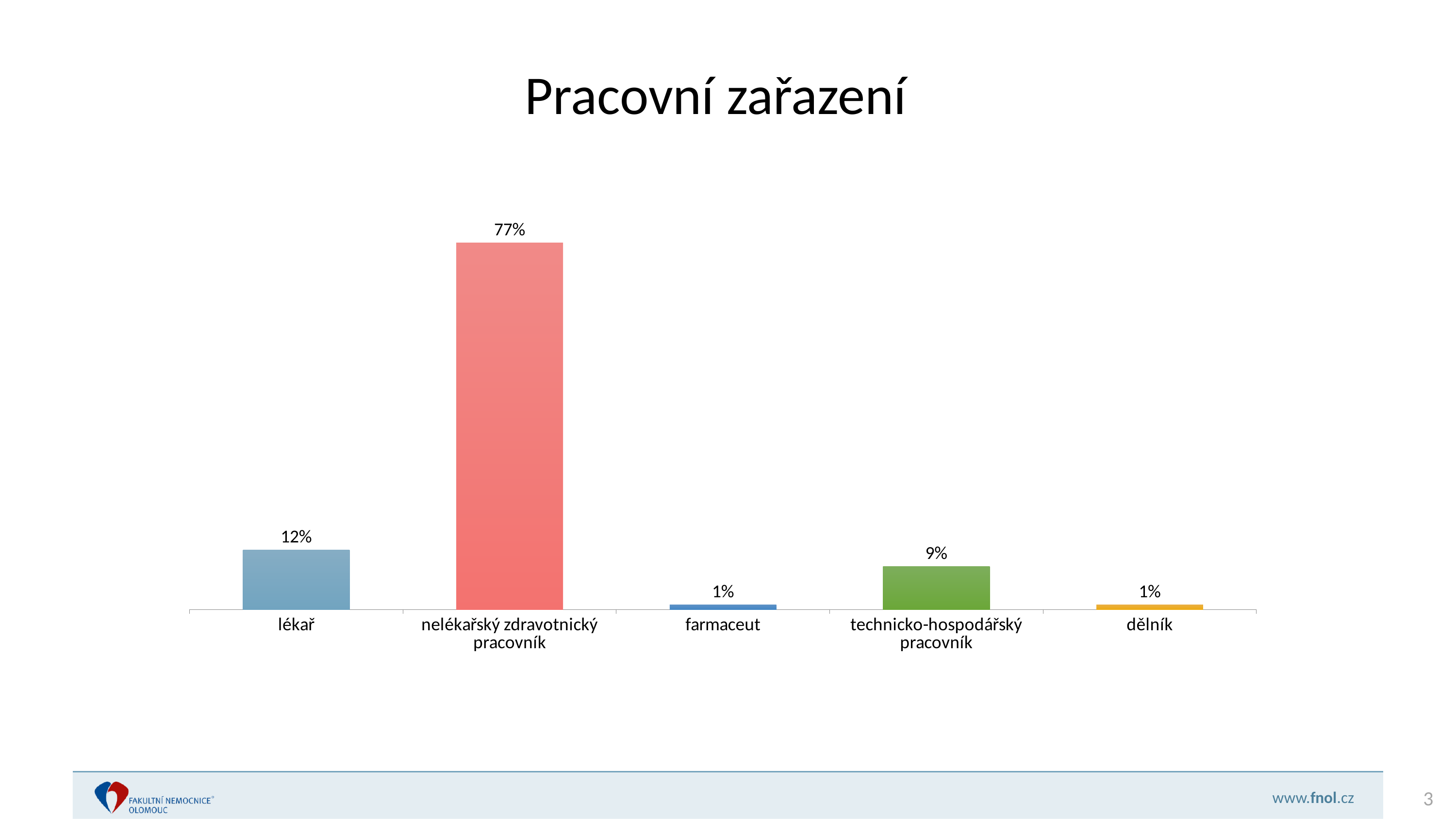
What is the difference between the values for lékař and technicko-hospodářský pracovník? 3% What kind of chart is shown on the slide? bar chart What is the value for lékař? 12% Which category has the highest value? nelékařský zdravotnický pracovník Which is larger, the value for lékař or the value for technicko-hospodářský pracovník? lékař What is the value for nelékařský zdravotnický pracovník? 77% Which is larger, the value for dělník or the value for technicko-hospodářský pracovník? technicko-hospodářský pracovník How many categories are shown in the chart? 5 What is the value for technicko-hospodářský pracovník? 9% What is the title of the slide? Pracovní zařazení What is the value for farmaceut? 1% What is the difference between the values for nelékařský zdravotnický pracovník and lékař? 65%